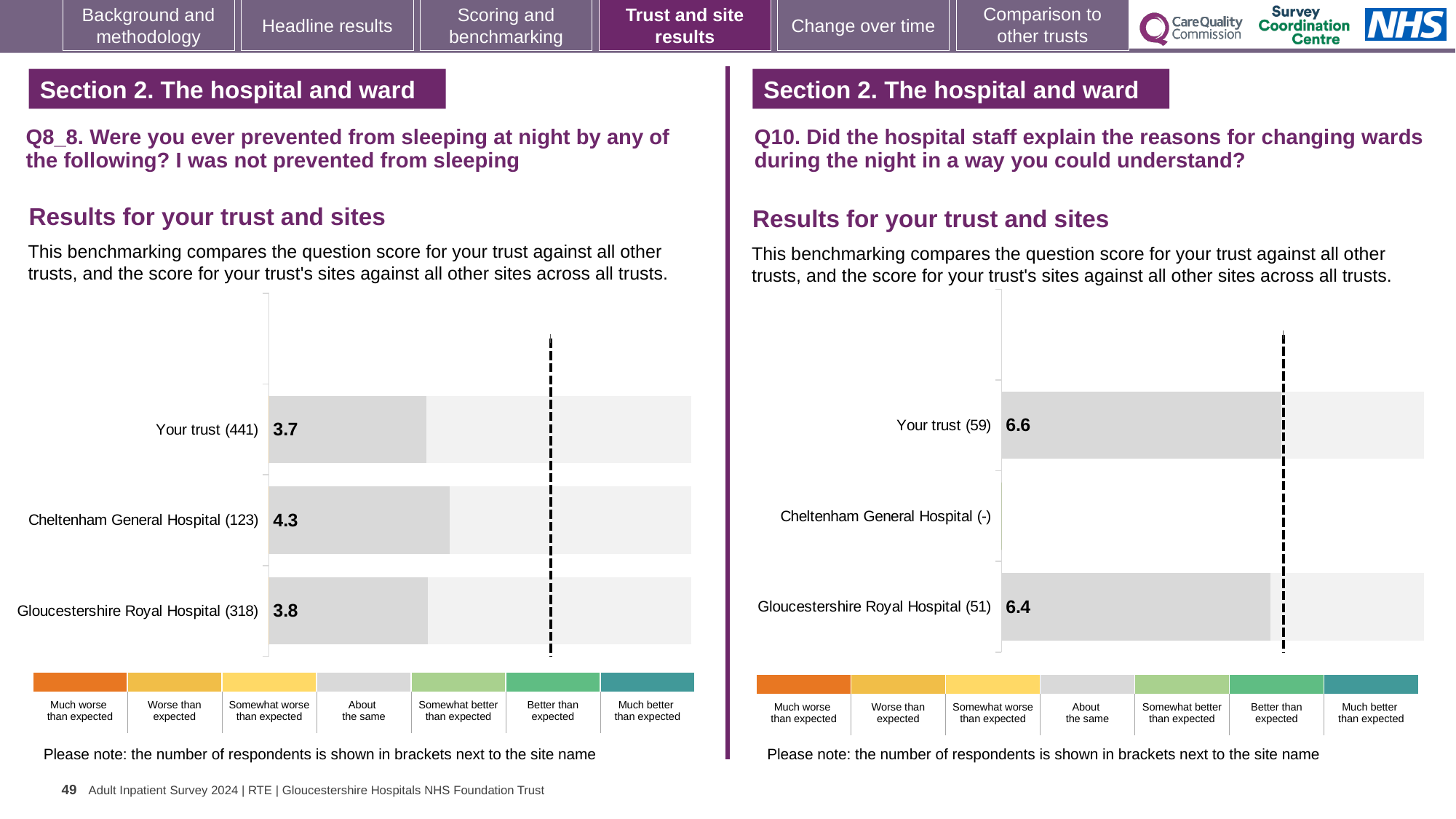
In the right chart (Q10), what is the score for Gloucestershire Royal Hospital? 6.4 What kind of chart is used on the left side of the slide (Q8_8)? Bar chart In the right chart (Q10), which is larger, the score for Your trust or for Gloucestershire Royal Hospital? Your trust In the right chart (Q10), what is the score for Your trust? 6.6 In the right chart (Q10), what is the difference between the scores for Your trust and Gloucestershire Royal Hospital? 0.2 In the left chart (Q8_8), what is the score for Cheltenham General Hospital? 4.3 In the left chart (Q8_8), how many respondents are shown for Gloucestershire Royal Hospital? 318 How many bars with a printed score are shown in the right chart (Q10)? 2 In the left chart (Q8_8), what is the difference between the scores for Cheltenham General Hospital and Your trust? 0.6 In the left chart (Q8_8), what is the score for Gloucestershire Royal Hospital? 3.8 In the left chart (Q8_8), which site or trust has the highest score? Cheltenham General Hospital In the left chart (Q8_8), what is the score for Your trust? 3.7